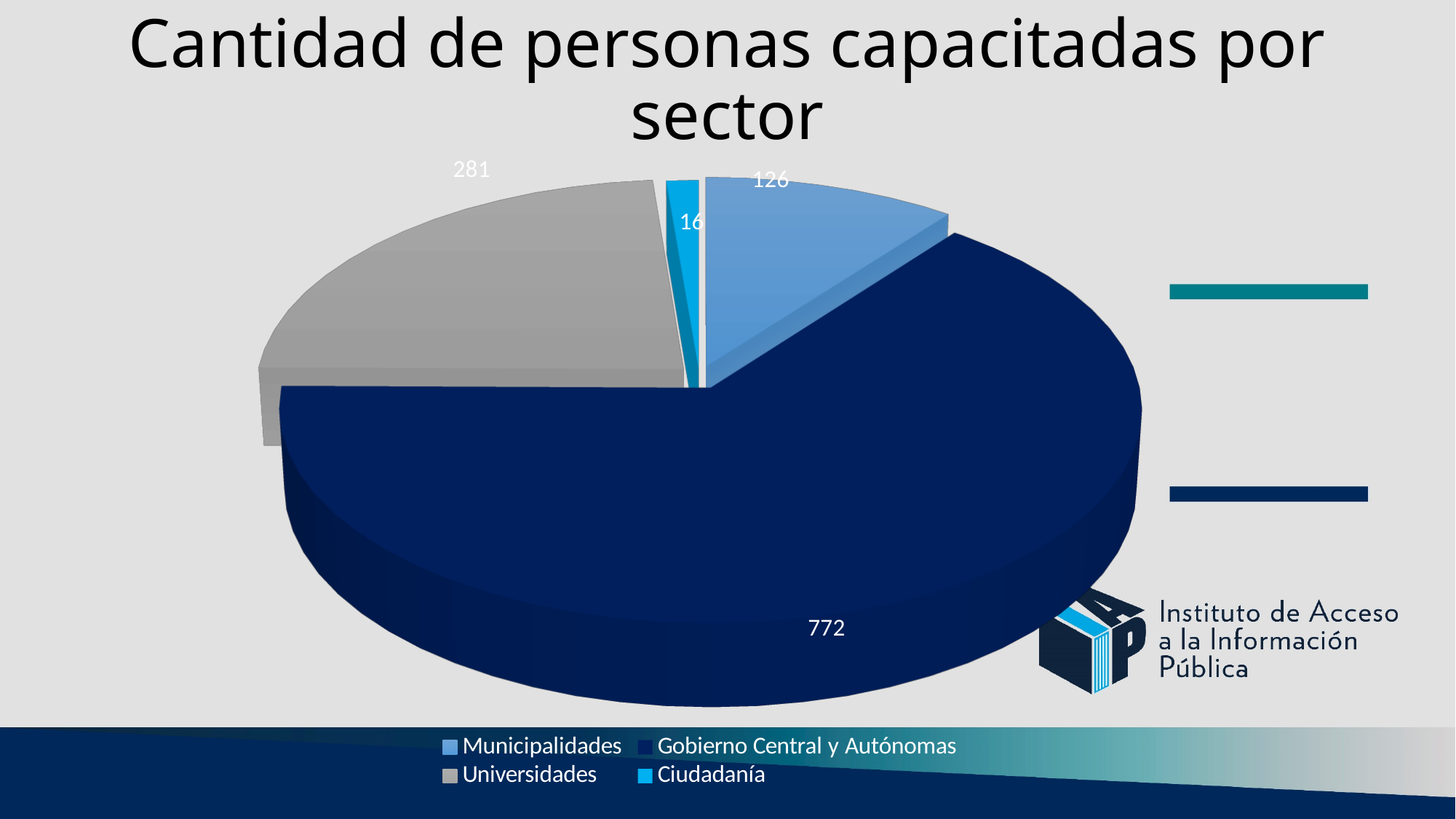
What is the value for Universidades? 281 What is the value for Municipalidades? 126 How many people were trained in the Gobierno Central y Autónomas sector? 772 Which sector has the largest number of people trained? Gobierno Central y Autónomas What is the title of the chart? Cantidad de personas capacitadas por sector What is the total number of people trained across all four sectors? 1195 What type of chart is shown on the slide? Pie chart How many sectors does the legend list? 4 Which sector has the smallest number of people trained? Ciudadanía Which is larger, the value for Universidades or the value for Municipalidades? Universidades What is the difference between the values for Universidades and Municipalidades? 155 What is the value for Ciudadanía? 16